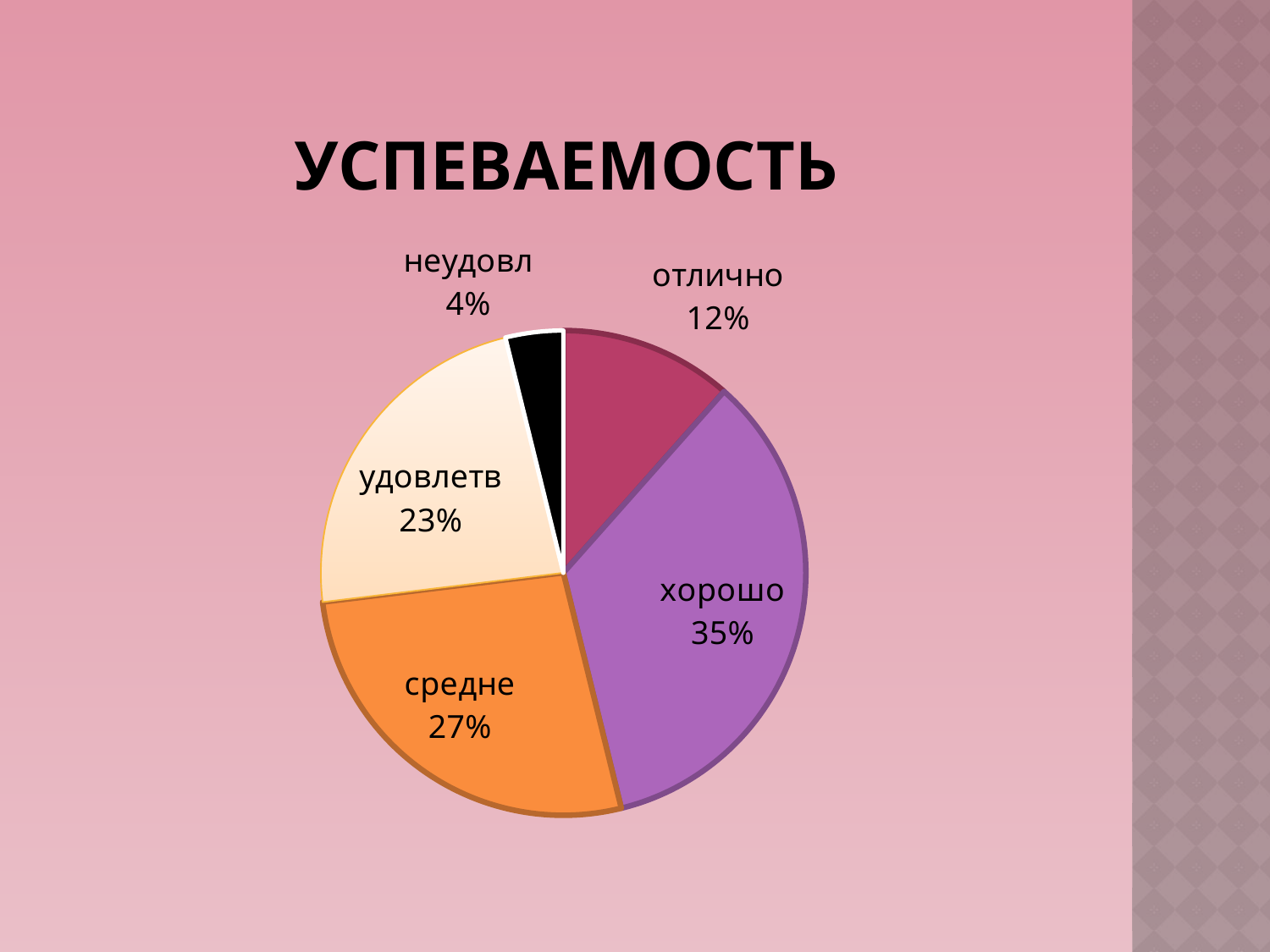
What colour is the "средне" slice? orange What is the title of the slide? УСПЕВАЕМОСТЬ What is the value shown for "отлично"? 12% What is the difference between the "хорошо" and "средне" values? 8% Which category has the largest slice of the pie? хорошо What is the value shown for "удовлетв"? 23% What share of the pie does the "хорошо" slice represent? 35% How many categories are shown in the pie chart? 5 What kind of chart is shown on the slide? pie chart Which category has the smallest slice of the pie? неудовл Which is larger, the "удовлетв" slice or the "отлично" slice? удовлетв What is the value shown for "неудовл"? 4%